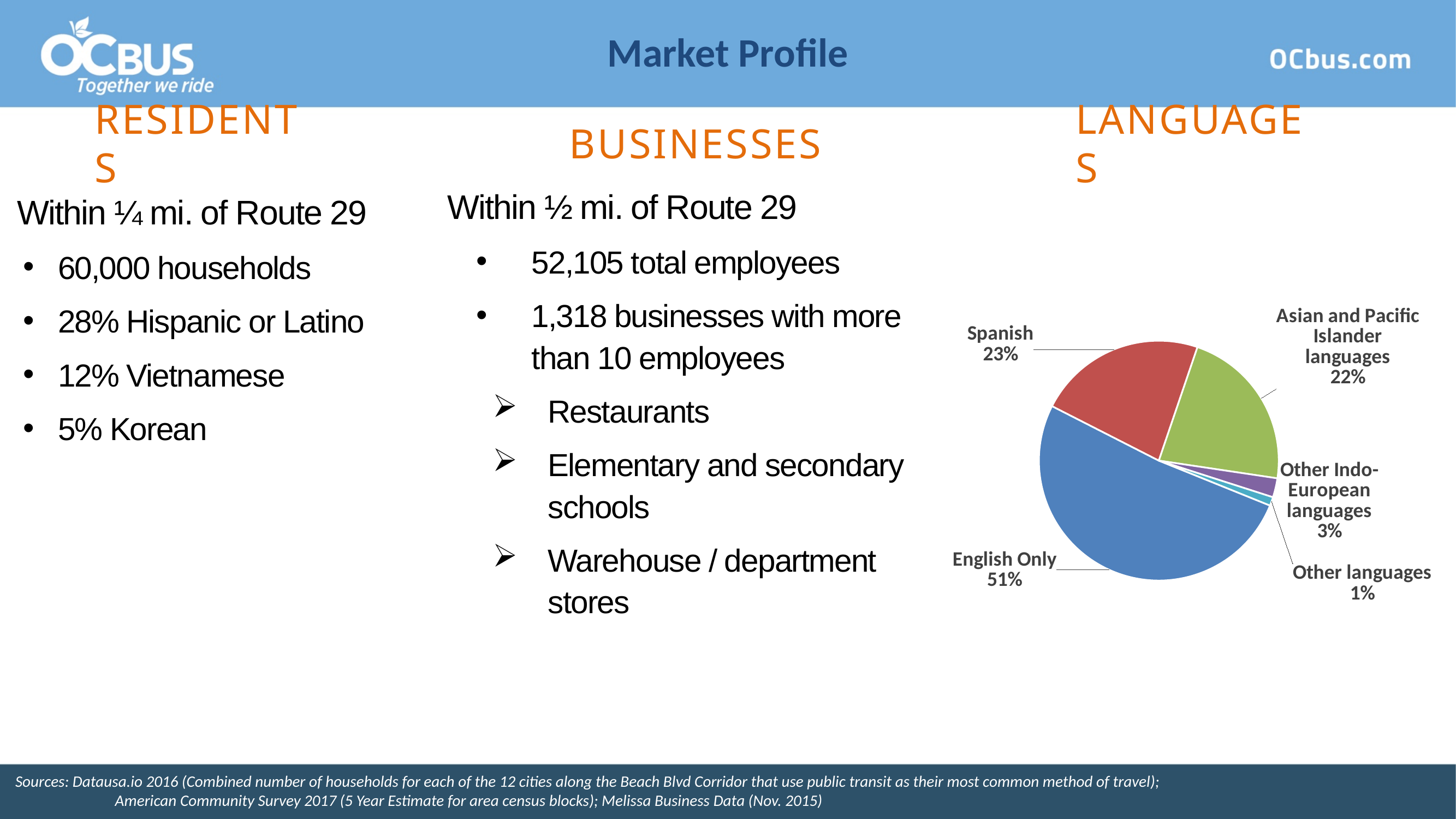
What share of the pie chart is English Only? 51% What share of the pie chart is Asian and Pacific Islander languages? 22% Which slice is larger, Spanish or Other Indo-European languages? Spanish What share of the pie chart is Spanish? 23% What share of the pie chart is Other Indo-European languages? 3% What kind of chart is shown under the Languages heading? Pie chart What share of the pie chart is Other languages? 1% What is the difference in percentage points between the English Only slice and the Spanish slice? 28 How many slices does the pie chart have? 5 Which language category has the smallest slice of the pie chart? Other languages What colour is the English Only slice of the pie chart? Blue Which language category has the largest slice of the pie chart? English Only